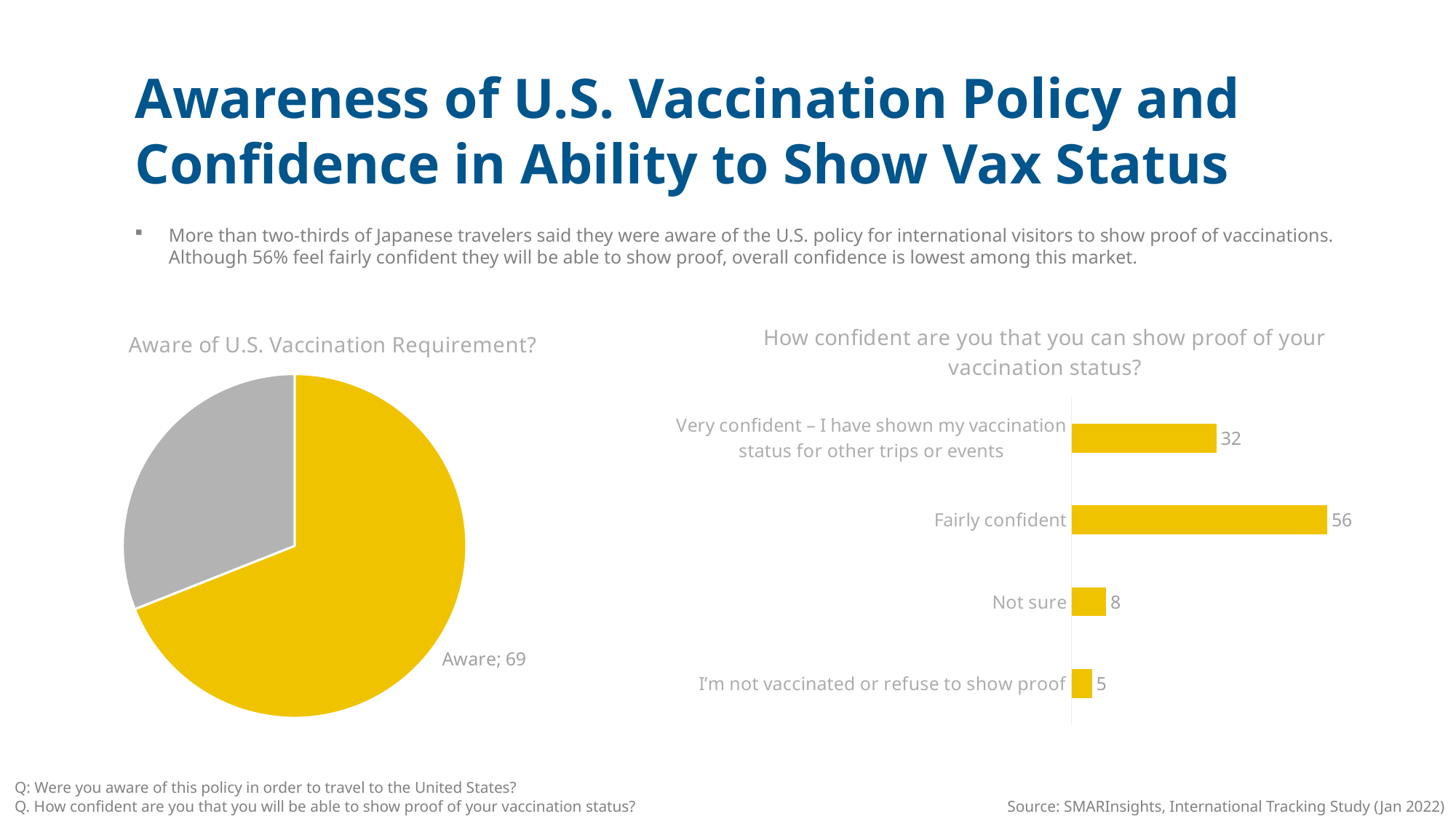
What kind of chart is the 'Aware of U.S. Vaccination Requirement?' chart? pie chart In the 'How confident are you that you can show proof of your vaccination status?' chart, which category has the highest value? Fairly confident In the 'Aware of U.S. Vaccination Requirement?' pie chart, what colour is the 'Aware' slice? yellow In the 'How confident are you that you can show proof of your vaccination status?' chart, what is the value for 'Fairly confident'? 56 How many categories are shown in the 'How confident are you that you can show proof of your vaccination status?' chart? 4 In the 'How confident are you that you can show proof of your vaccination status?' chart, what is the value for 'I'm not vaccinated or refuse to show proof'? 5 In the 'How confident are you that you can show proof of your vaccination status?' chart, what is the value for 'Not sure'? 8 What kind of chart is the 'How confident are you that you can show proof of your vaccination status?' chart? bar chart In the 'How confident are you that you can show proof of your vaccination status?' chart, which is larger: 'Not sure' or 'I'm not vaccinated or refuse to show proof'? Not sure In the 'Aware of U.S. Vaccination Requirement?' pie chart, what value is shown for the 'Aware' slice? 69 In the 'How confident are you that you can show proof of your vaccination status?' chart, which category has the lowest value? I'm not vaccinated or refuse to show proof In the 'How confident are you that you can show proof of your vaccination status?' chart, what is the difference between 'Fairly confident' and 'Very confident – I have shown my vaccination status for other trips or events'? 24